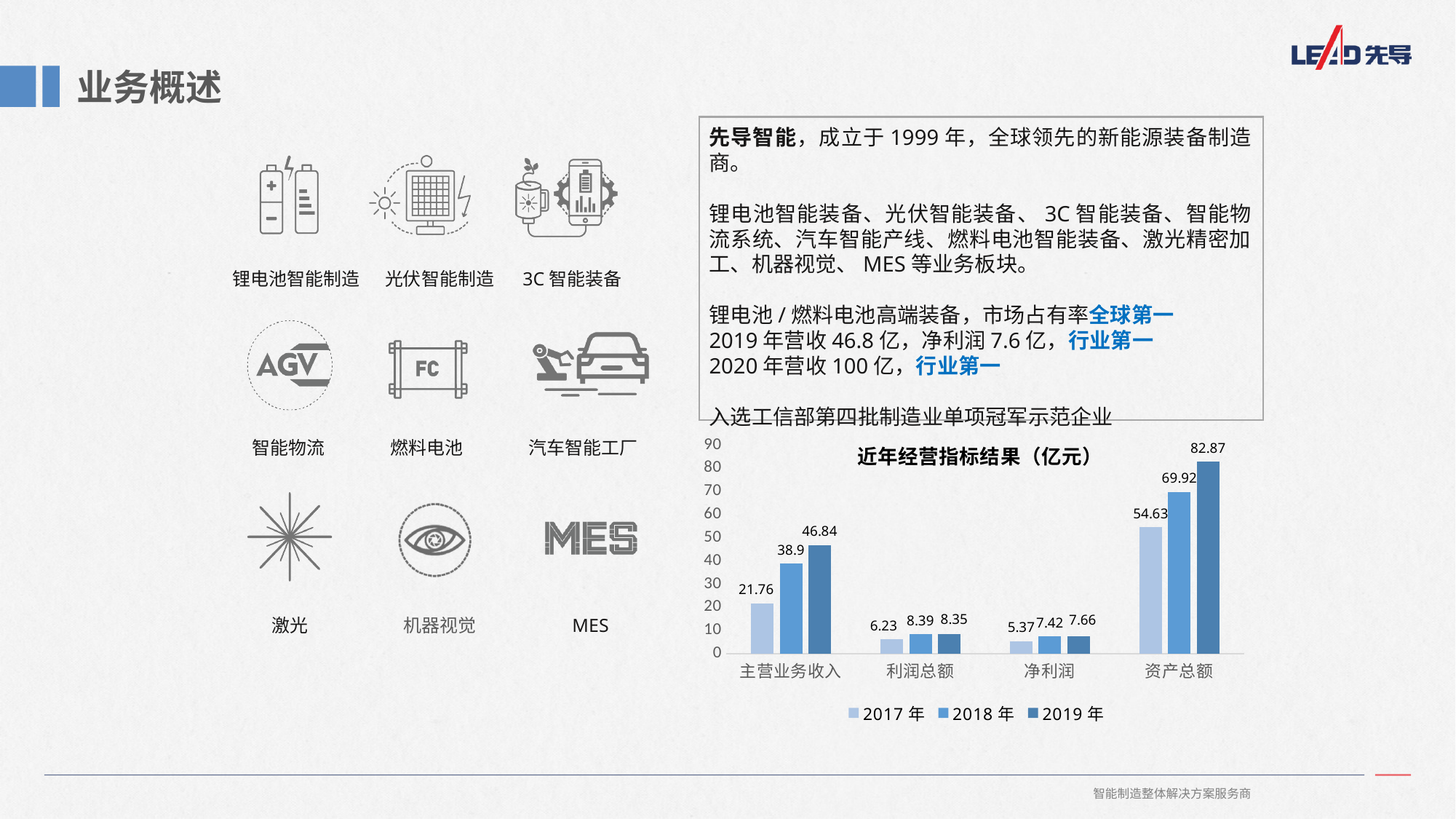
What is the value for 利润总额 in 2017 年? 6.23 How many categories are shown on the x axis? 4 What is the value for 资产总额 in 2017 年? 54.63 Which is larger for 资产总额: the 2018 年 value or the 2019 年 value? 2019 年 What is the value for 主营业务收入 in 2019 年? 46.84 Which category has the highest value in 2019 年? 资产总额 How many series does the legend list? 3 What is the difference between the 2019 年 and 2017 年 values for 主营业务收入? 25.08 Which category has the lowest value in 2017 年? 净利润 What is the value for 净利润 in 2018 年? 7.42 What kind of chart is shown? bar chart What is the title of the chart? 近年经营指标结果（亿元）